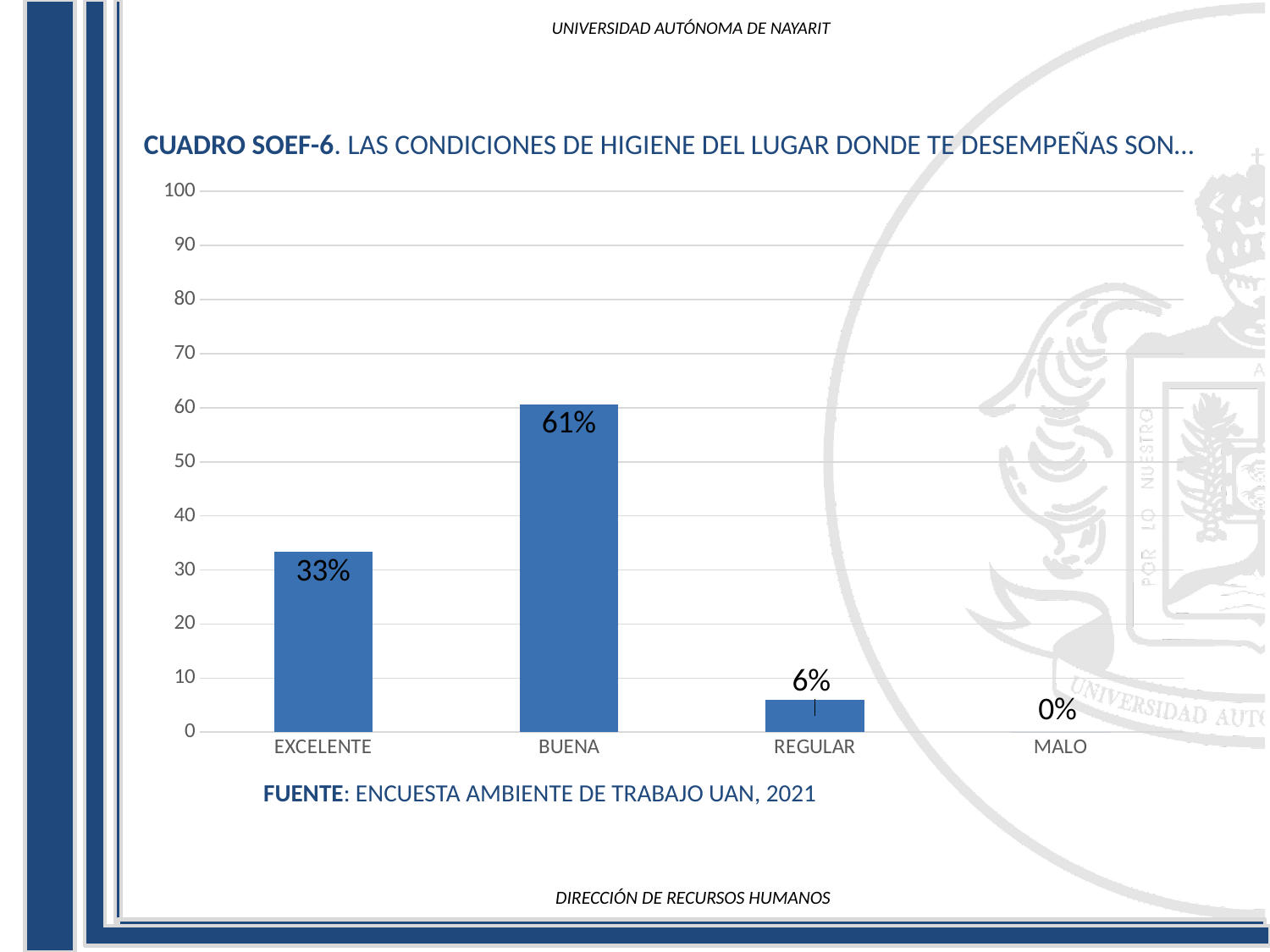
What is the value for EXCELENTE? 33% What is the value for MALO? 0% What is the value for REGULAR? 6% What is the difference between the values for BUENA and EXCELENTE? 28% Which category has the highest value? BUENA How many categories are shown on the x axis? 4 What kind of chart is shown on the slide? Bar chart Which category has the lowest value? MALO What is the value for BUENA? 61% Is the value for BUENA greater or less than 50? greater Which is larger, the value for EXCELENTE or the value for REGULAR? EXCELENTE What source is cited below the chart? ENCUESTA AMBIENTE DE TRABAJO UAN, 2021